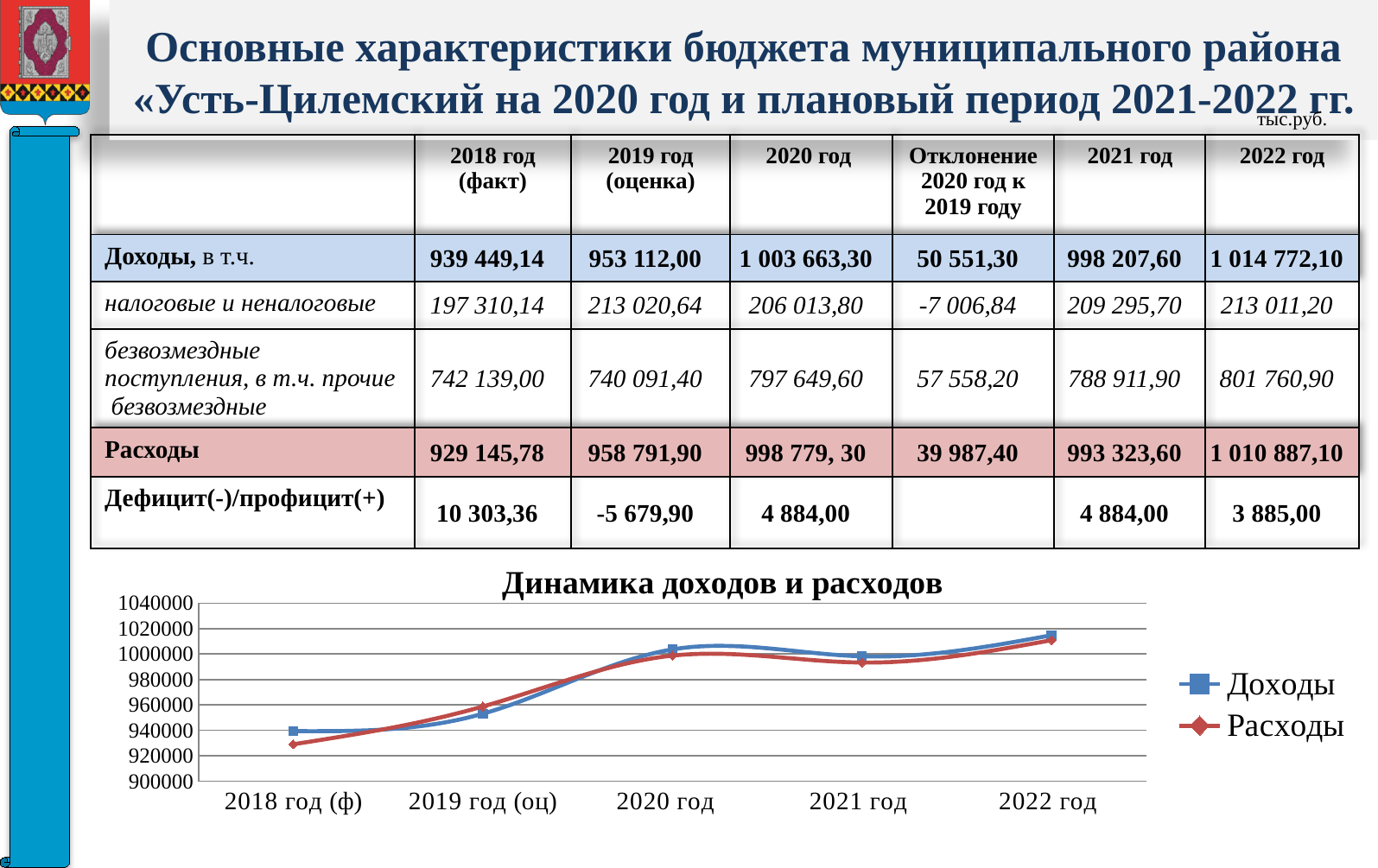
What kind of chart is shown under the title "Динамика доходов и расходов"? line chart In the chart "Динамика доходов и расходов", is the Доходы value for 2018 год (ф) greater or less than 960000? less How many series does the legend of the chart "Динамика доходов и расходов" list? 2 In the chart "Динамика доходов и расходов", at which x-axis category is the Доходы series highest? 2022 год In the chart "Динамика доходов и расходов", is the Доходы value for 2022 год greater or less than 1000000? greater In the chart "Динамика доходов и расходов", at which x-axis category is the Расходы series highest? 2022 год How many points along the x axis does the chart "Динамика доходов и расходов" have? 5 In the chart "Динамика доходов и расходов", is the Расходы value for 2018 год (ф) greater or less than 940000? less What are the two legend entries of the chart "Динамика доходов и расходов"? Доходы, Расходы In the chart "Динамика доходов и расходов", at which x-axis category is the Расходы series lowest? 2018 год (ф) In the chart "Динамика доходов и расходов", does the Доходы series rise or fall from 2018 год (ф) to 2022 год? rise In the chart "Динамика доходов и расходов", which series is higher at 2018 год (ф), Доходы or Расходы? Доходы